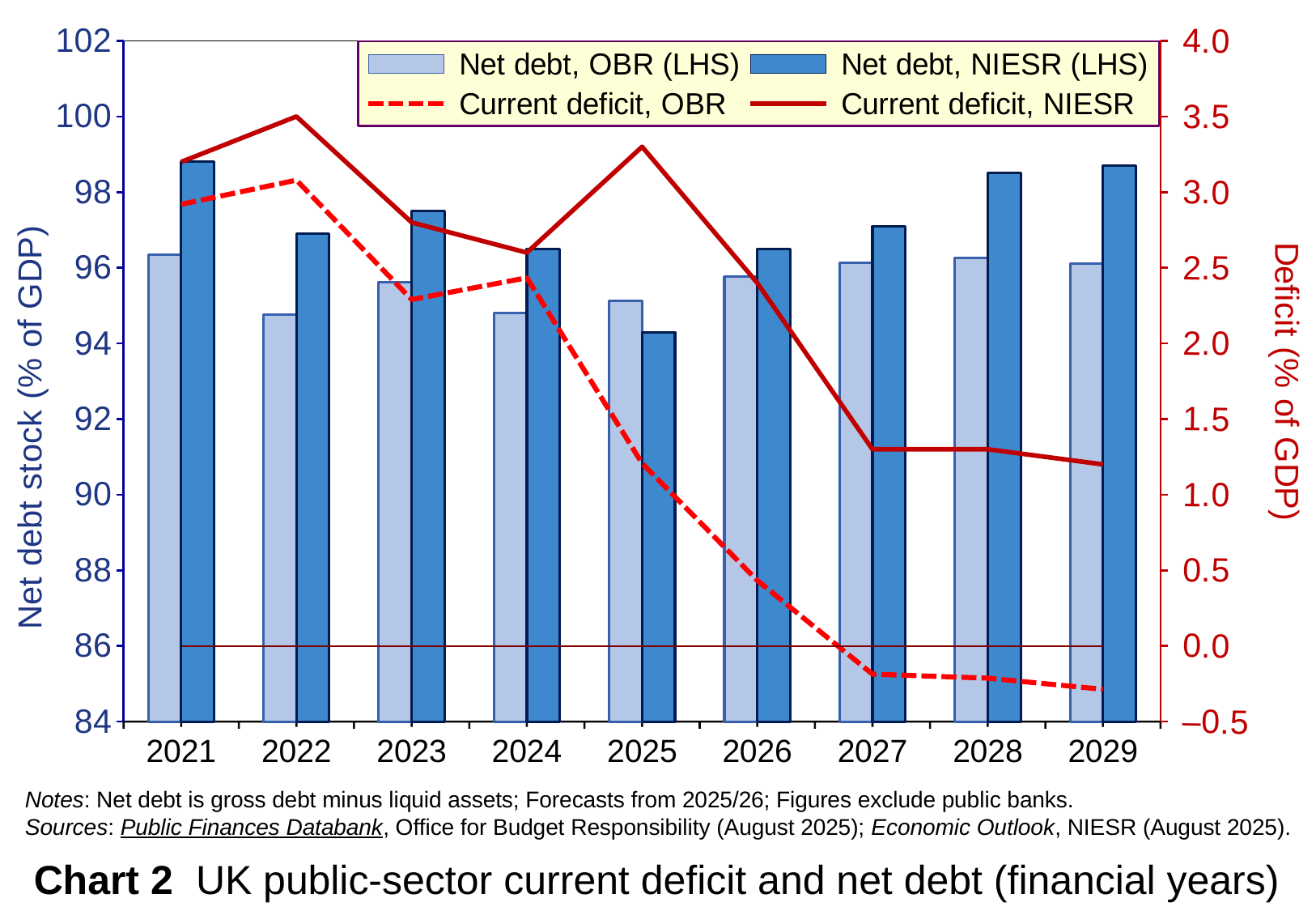
Is the Current deficit, OBR value for 2027 greater or less than 0.0? less How many financial years are shown on the x axis? 9 In which year does the Current deficit, NIESR line reach its highest value? 2022 Is the Current deficit, NIESR value for 2022 greater or less than 3.0? greater How many series does the legend list? 4 In 2025, which is larger: Net debt, OBR or Net debt, NIESR? Net debt, OBR Does the Current deficit, OBR line rise or fall overall from 2021 to 2029? fall In which year does the Current deficit, OBR line reach its highest value? 2022 What kind of chart is this? Combined bar and line chart Is the Net debt, NIESR value for 2025 greater or less than 96? less In which year is the Net debt, NIESR bar lowest? 2025